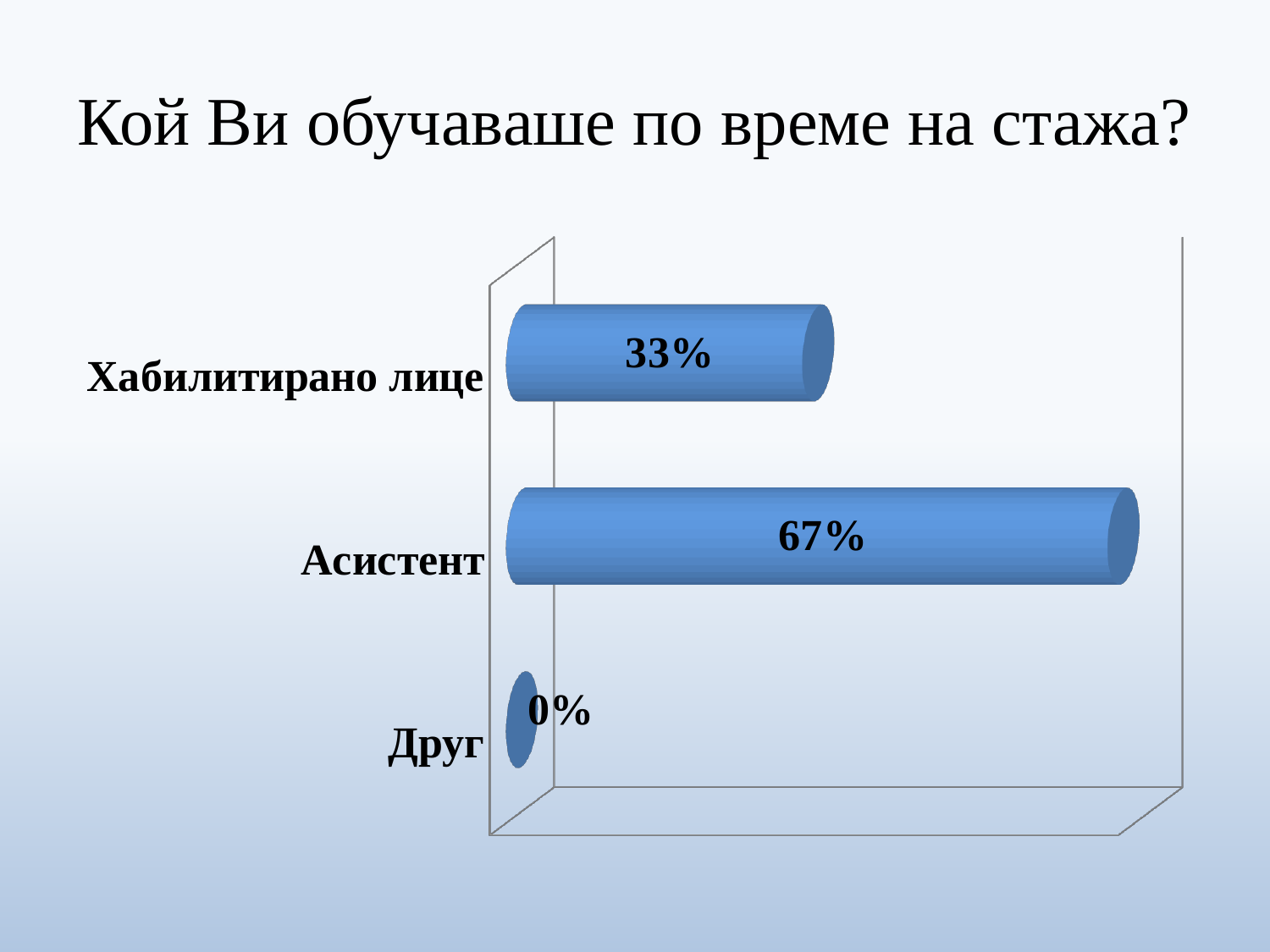
What is the value for Хабилитирано лице? 33% Which category has the lowest value? Друг What is the title of the slide? Кой Ви обучаваше по време на стажа? What is the value for Друг? 0% Which category has the highest value? Асистент How many categories are shown in the chart? 3 What kind of chart is shown on the slide? Bar chart What is the difference between the values for Хабилитирано лице and Друг? 33% What is the difference between the values for Асистент and Хабилитирано лице? 34% What is the value for Асистент? 67% Which is larger, the value for Хабилитирано лице or the value for Асистент? Асистент What colour are the bars in the chart? Blue